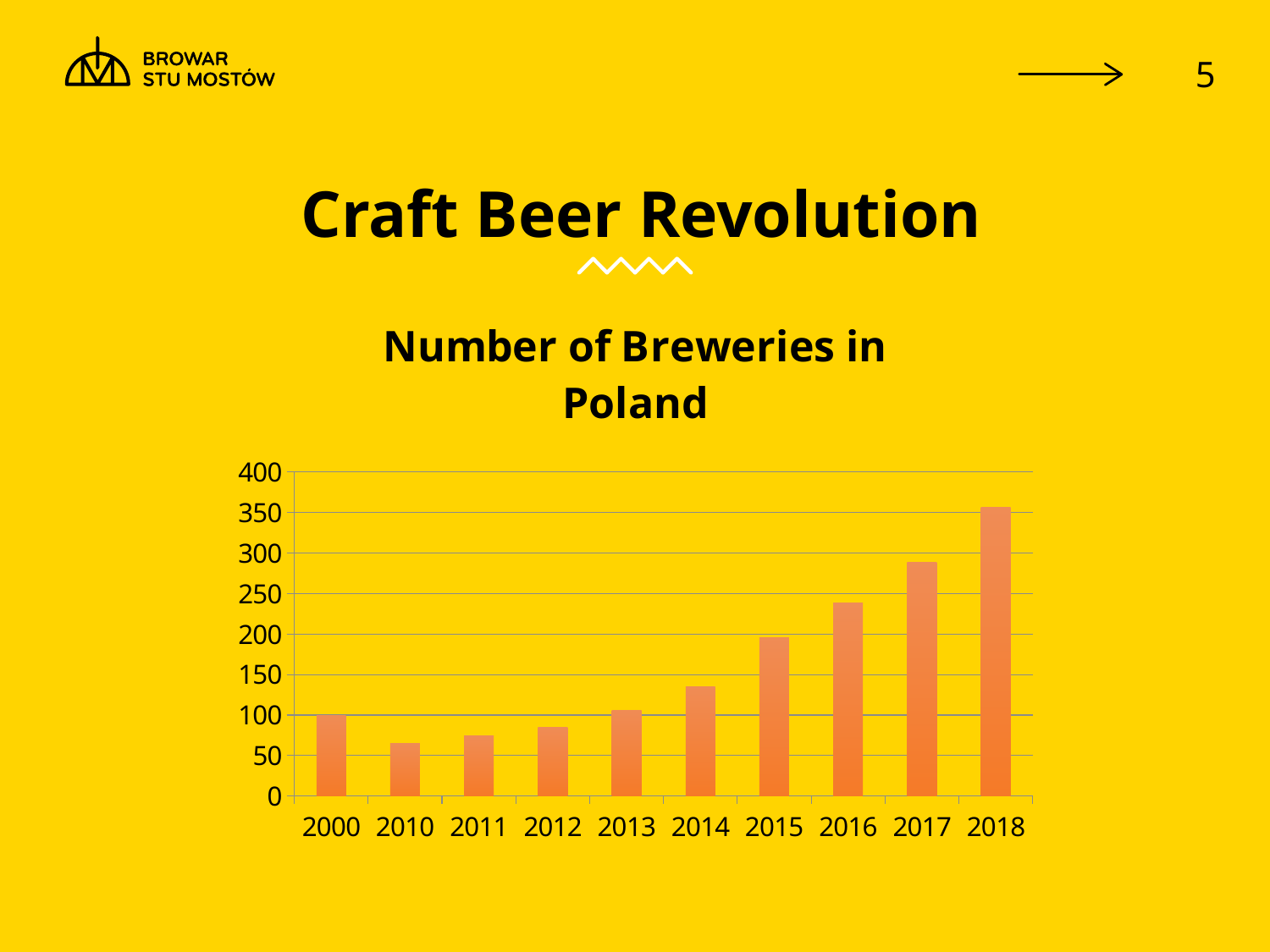
Is the value for 2018 greater or less than 300? greater Which year has the highest number of breweries? 2018 Is the value for 2016 greater or less than 200? greater What is the title of the chart? Number of Breweries in Poland Which year has the lowest number of breweries? 2010 Which is larger, the value for 2017 or the value for 2016? 2017 Is the value for 2012 greater or less than 100? less How many years are shown on the x axis of the chart? 10 Do the values rise or fall from 2010 to 2018? rise What kind of chart is shown on the slide? bar chart